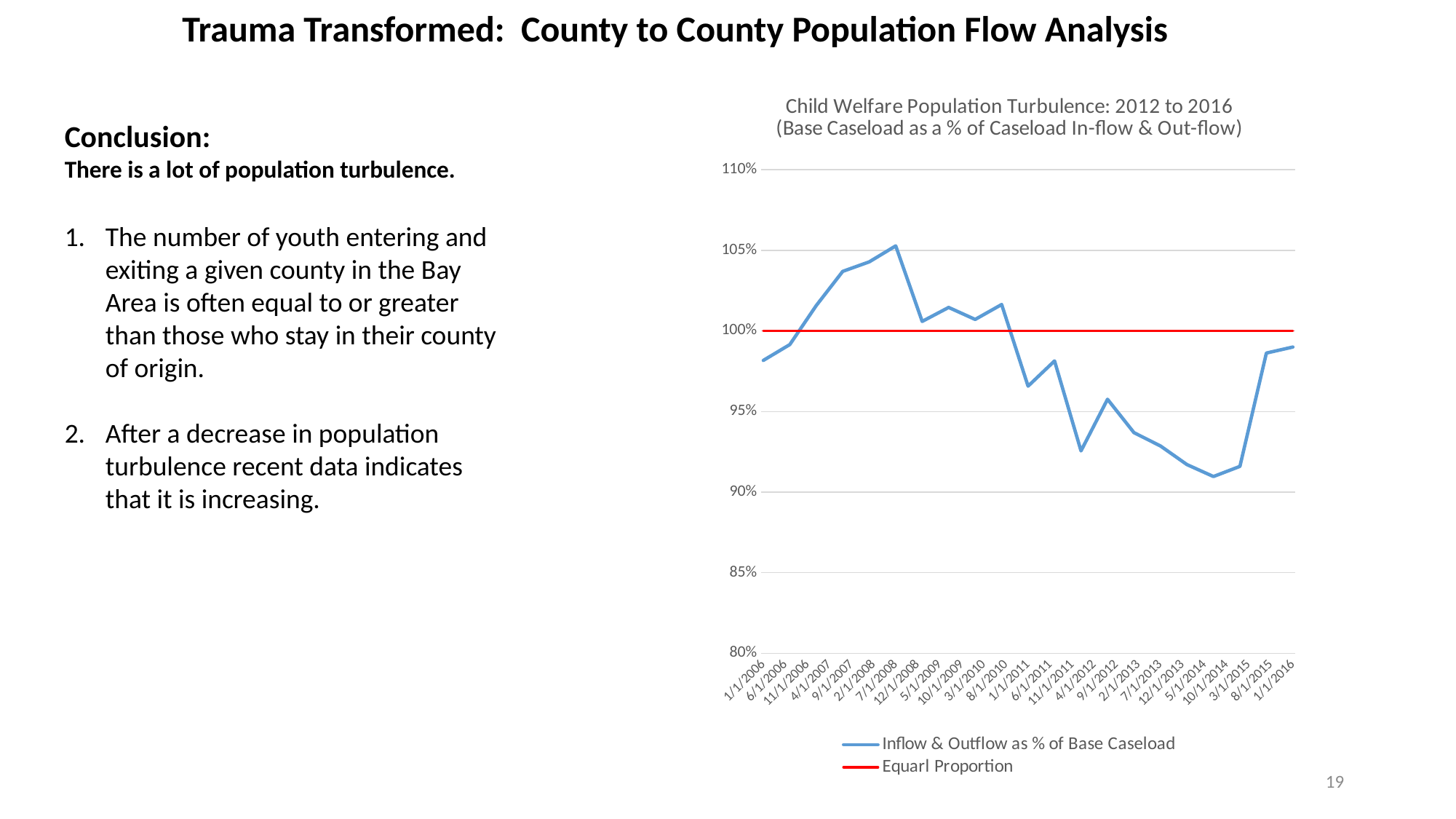
Is the Inflow & Outflow as % of Base Caseload value at 7/1/2008 greater or less than 100%? greater Does the Inflow & Outflow as % of Base Caseload line rise or fall between 1/1/2006 and 7/1/2008? Rise How many dates are labelled along the x axis of the chart? 25 What colour is the Equarl Proportion line in the chart? Red Is the Inflow & Outflow as % of Base Caseload value at 10/1/2014 greater or less than 95%? less Is the Inflow & Outflow as % of Base Caseload value at 1/1/2011 greater or less than 100%? less At what value does the Equarl Proportion line sit? 100% What kind of chart is shown on the slide? Line chart How many series does the chart legend list? 2 Which is larger, the Inflow & Outflow as % of Base Caseload value at 7/1/2008 or at 10/1/2014? 7/1/2008 At which date does the Inflow & Outflow as % of Base Caseload line reach its highest value? 7/1/2008